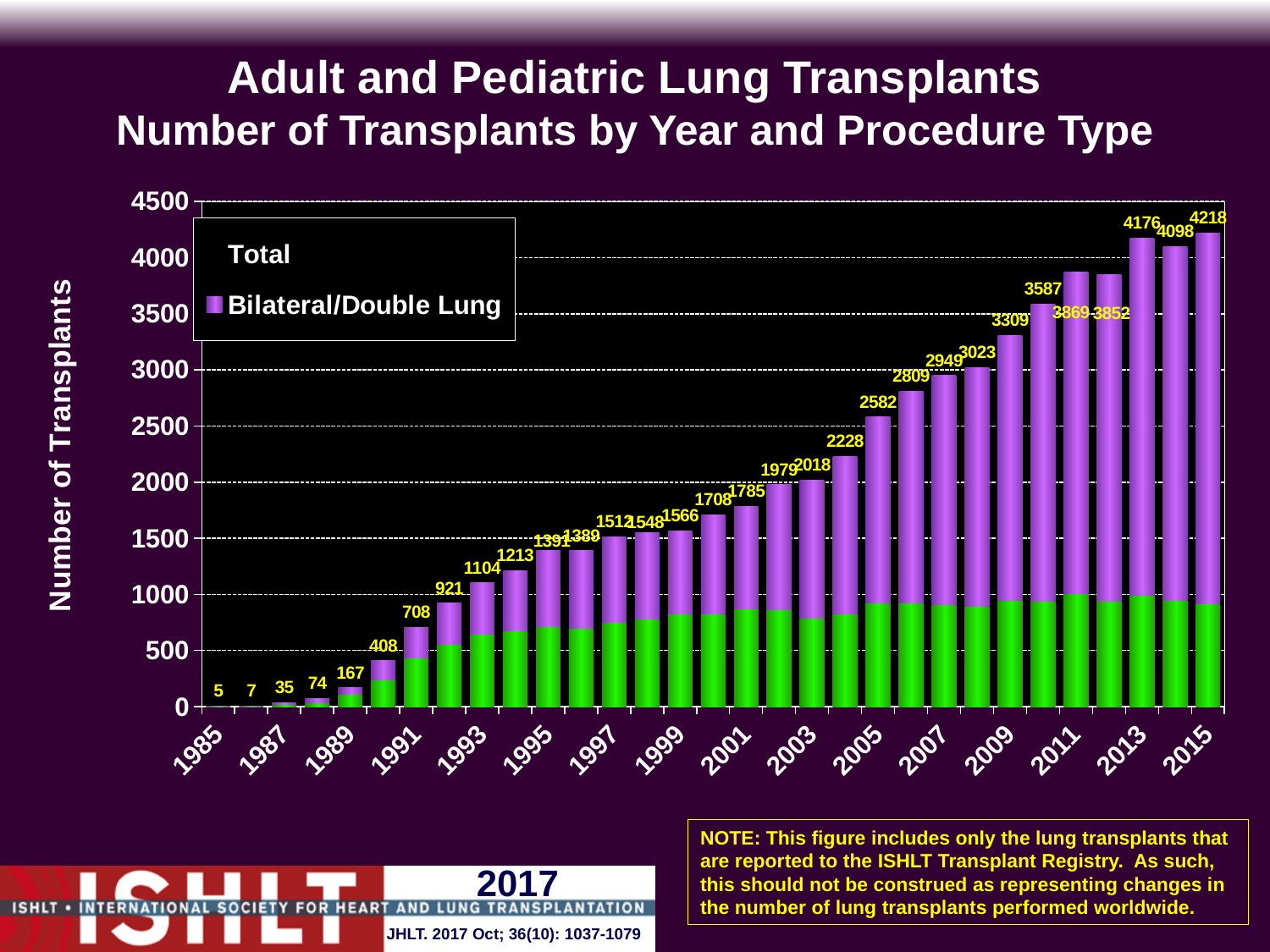
Which year had more total transplants, 2013 or 2014? 2013 What is the total number of lung transplants shown for 2015? 4218 How many entries does the chart legend list? 2 Is the green (lower) segment of the 2015 bar greater or less than 1000? less What is the difference between the total transplants in 2005 and 2004? 354 What is the difference between the total transplants in 2015 and 2014? 120 What kind of chart is shown on the slide? Stacked bar chart Which year has the lowest total number of transplants? 1985 Do the total transplant numbers generally rise or fall from 1985 to 2015? Rise What is the total number of lung transplants shown for 1990? 408 Which year has the highest total number of transplants? 2015 How many years (bars) are plotted on the chart? 31